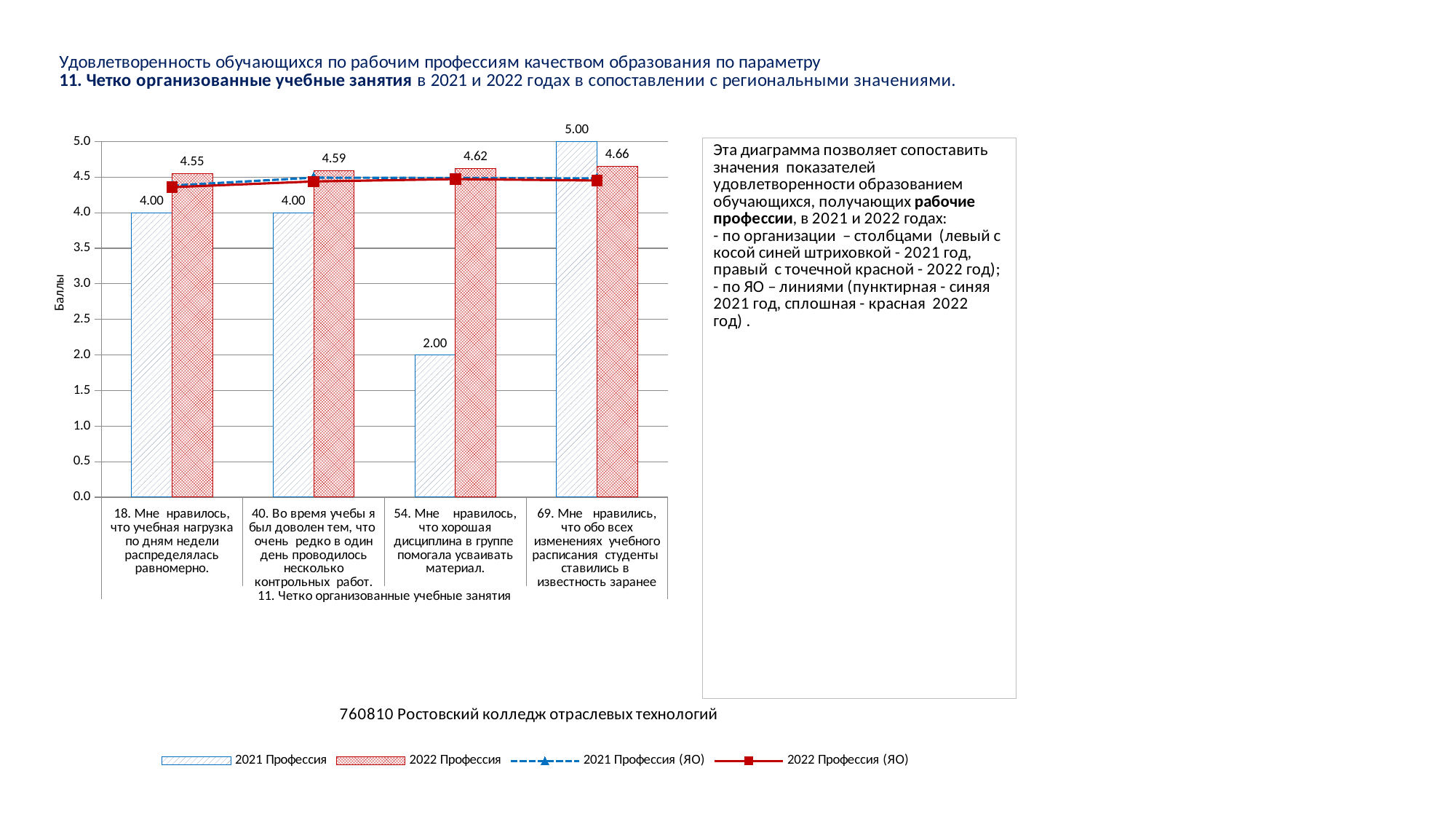
Which category has the lowest 2021 Профессия value? 54. Мне нравилось, что хорошая дисциплина в группе помогала усваивать материал Is the 2021 Профессия (ЯО) line value for category 18 greater or less than 4.0? greater What kind of chart is this? Combined bar and line chart What is the difference between the 2022 Профессия and 2021 Профессия values for category 54? 2.62 Do the 2022 Профессия bar values rise or fall from left to right across the categories? rise What is the value of the 2021 Профессия bar for category 18 (Мне нравилось, что учебная нагрузка по дням недели распределялась равномерно)? 4.00 For category 69, which is larger: the 2021 Профессия bar or the 2022 Профессия bar? 2021 Профессия How many series does the legend list? 4 What is the value of the 2022 Профессия bar for category 69 (Мне нравились, что обо всех изменениях учебного расписания студенты ставились в известность заранее)? 4.66 What is the value of the 2022 Профессия bar for category 54 (Мне нравилось, что хорошая дисциплина в группе помогала усваивать материал)? 4.62 Which category has the highest 2021 Профессия value? 69. Мне нравились, что обо всех изменениях учебного расписания студенты ставились в известность заранее How many categories are shown on the x axis? 4